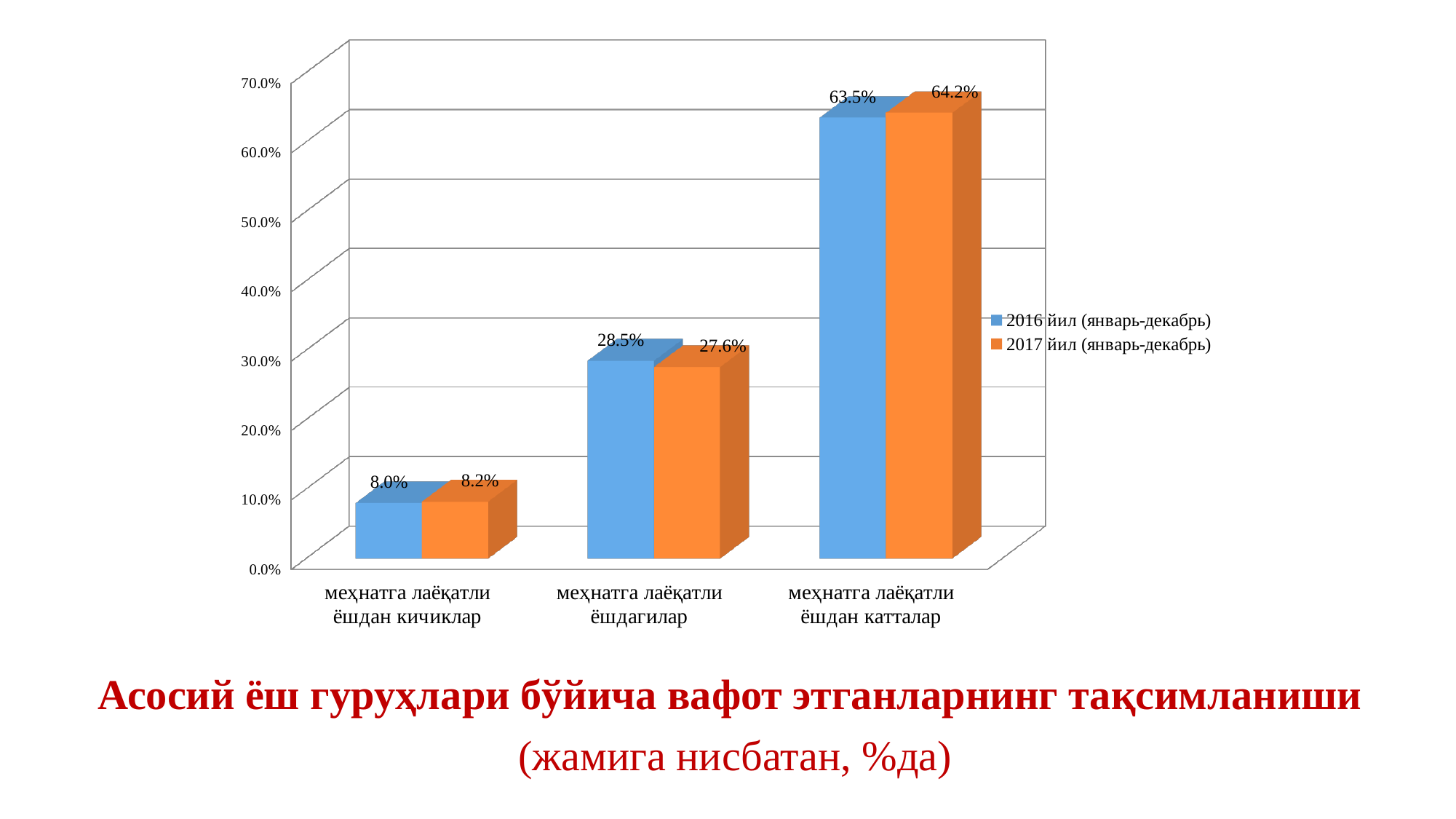
What is the value for "меҳнатга лаёқатли ёшдан катталар" in the 2016 йил (январь-декабрь) series? 63.5% Which category has the lowest value in the 2016 йил (январь-декабрь) series? меҳнатга лаёқатли ёшдан кичиклар For "меҳнатга лаёқатли ёшдагилар", which series has the larger value, 2016 йил (январь-декабрь) or 2017 йил (январь-декабрь)? 2016 йил (январь-декабрь) What is the value for "меҳнатга лаёқатли ёшдан кичиклар" in the 2016 йил (январь-декабрь) series? 8.0% Which colour represents the 2017 йил (январь-декабрь) series? orange What is the value for "меҳнатга лаёқатли ёшдагилар" in the 2017 йил (январь-декабрь) series? 27.6% Is the 2017 йил (январь-декабрь) value for "меҳнатга лаёқатли ёшдан кичиклар" greater or less than 10.0%? less What kind of chart is shown on the slide? bar chart What is the difference between the 2017 and 2016 values for "меҳнатга лаёқатли ёшдан катталар"? 0.7% Which category has the highest value in the 2017 йил (январь-декабрь) series? меҳнатга лаёқатли ёшдан катталар How many categories are shown on the x axis? 3 How many series does the legend list? 2